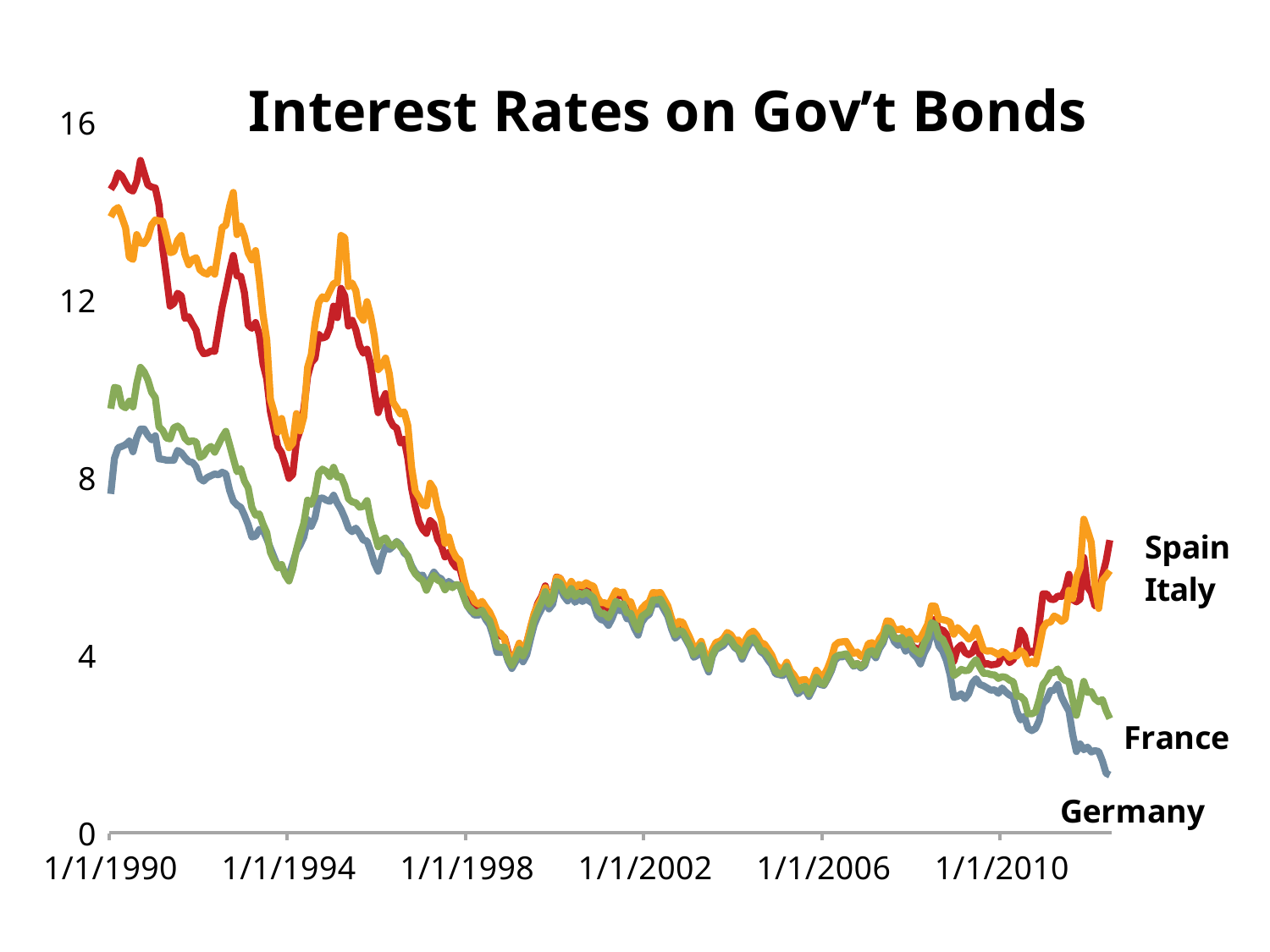
Which countries are labelled on the chart? Spain, Italy, France, Germany Is Spain's interest rate at the start of 1990 greater or less than 12? greater Is Germany's interest rate at the end of the series greater or less than 4? less What kind of chart is shown on the slide? Line chart Which country has the highest interest rate at the end of the series? Spain Which country has the lowest interest rate at the start of the series in 1990? Germany What is the title of the chart? Interest Rates on Gov't Bonds Which country has the lowest interest rate at the end of the series? Germany At the end of the series, which is higher: Spain's interest rate or Germany's? Spain Is Germany's interest rate at the start of 1990 greater or less than 12? less Overall, do the interest rates rise or fall from 1990 to the end of the series? Fall How many countries' series are plotted on the chart? 4